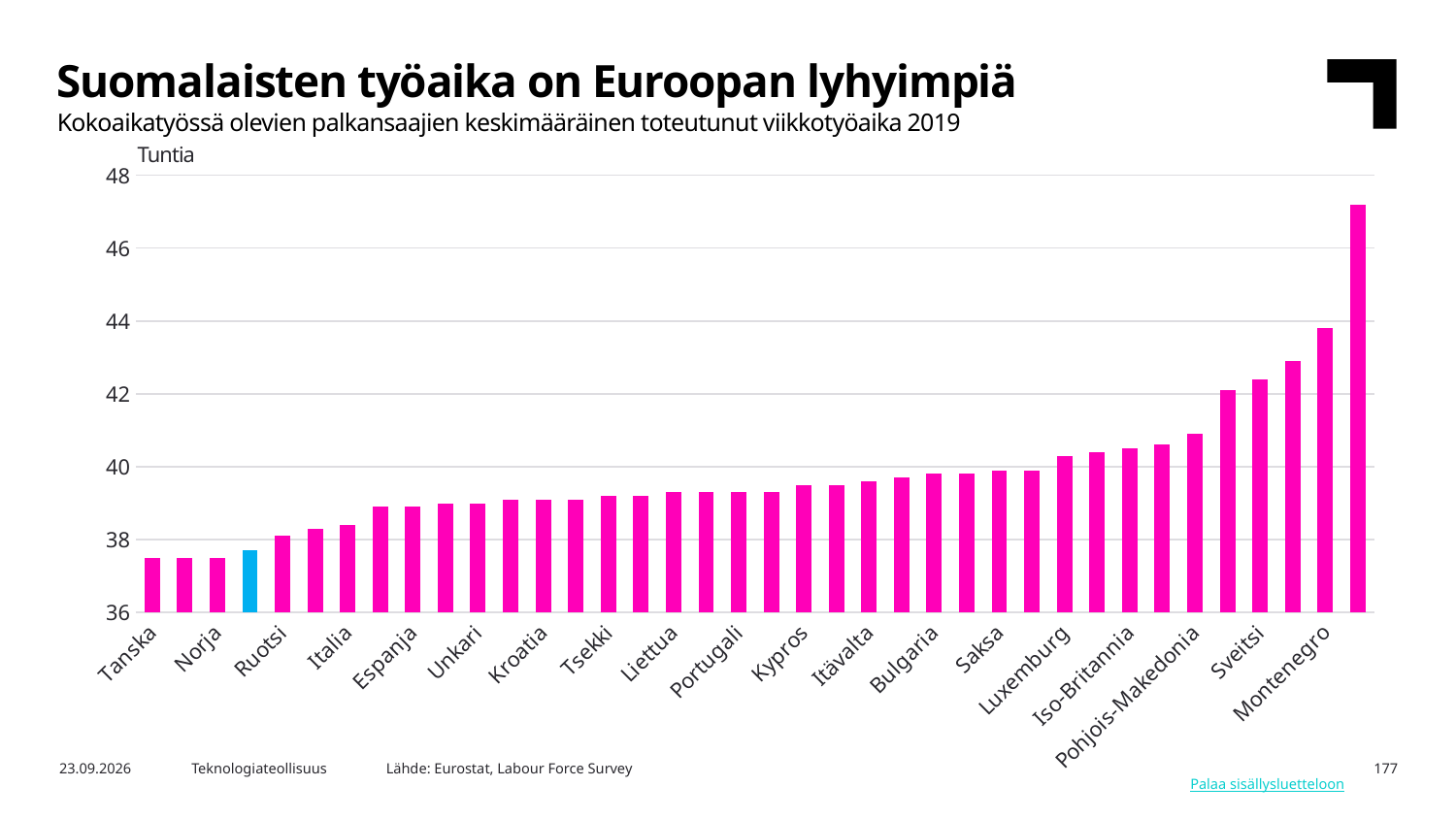
Do the values rise or fall from left to right along the x axis? rise Which has a higher value, Montenegro or Tanska? Montenegro Is the value for Pohjois-Makedonia greater or less than 40? greater Is the value for Espanja greater or less than 40? less Is the value for Sveitsi greater or less than 40? greater What unit is shown at the top of the y axis? Tuntia Which has a higher value, Italia or Sveitsi? Sveitsi Which has a higher value, Ruotsi or Espanja? Espanja What kind of chart is shown on the slide? bar chart